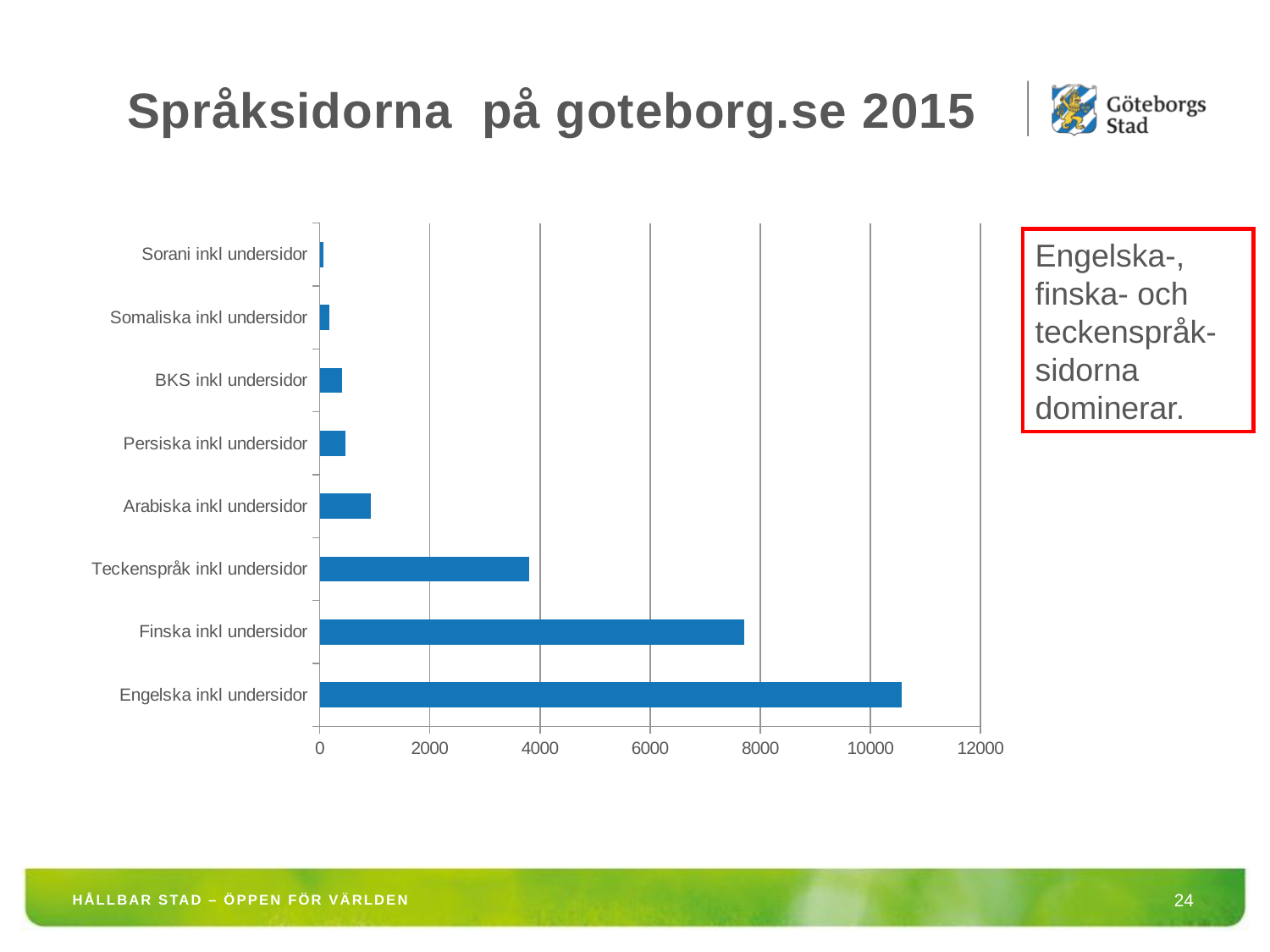
Is the value for Engelska inkl undersidor greater or less than 10000? greater Is the value for Finska inkl undersidor greater or less than 8000? less Is the value for Finska inkl undersidor greater or less than 6000? greater What kind of chart is shown on the slide? bar chart Which is larger, the value for Finska inkl undersidor or Teckenspråk inkl undersidor? Finska inkl undersidor Which category has the highest value in the chart? Engelska inkl undersidor What is the title of the slide containing the chart? Språksidorna på goteborg.se 2015 How many categories are plotted in the chart? 8 Which category has the lowest value in the chart? Sorani inkl undersidor Which is larger, the value for Arabiska inkl undersidor or Persiska inkl undersidor? Arabiska inkl undersidor